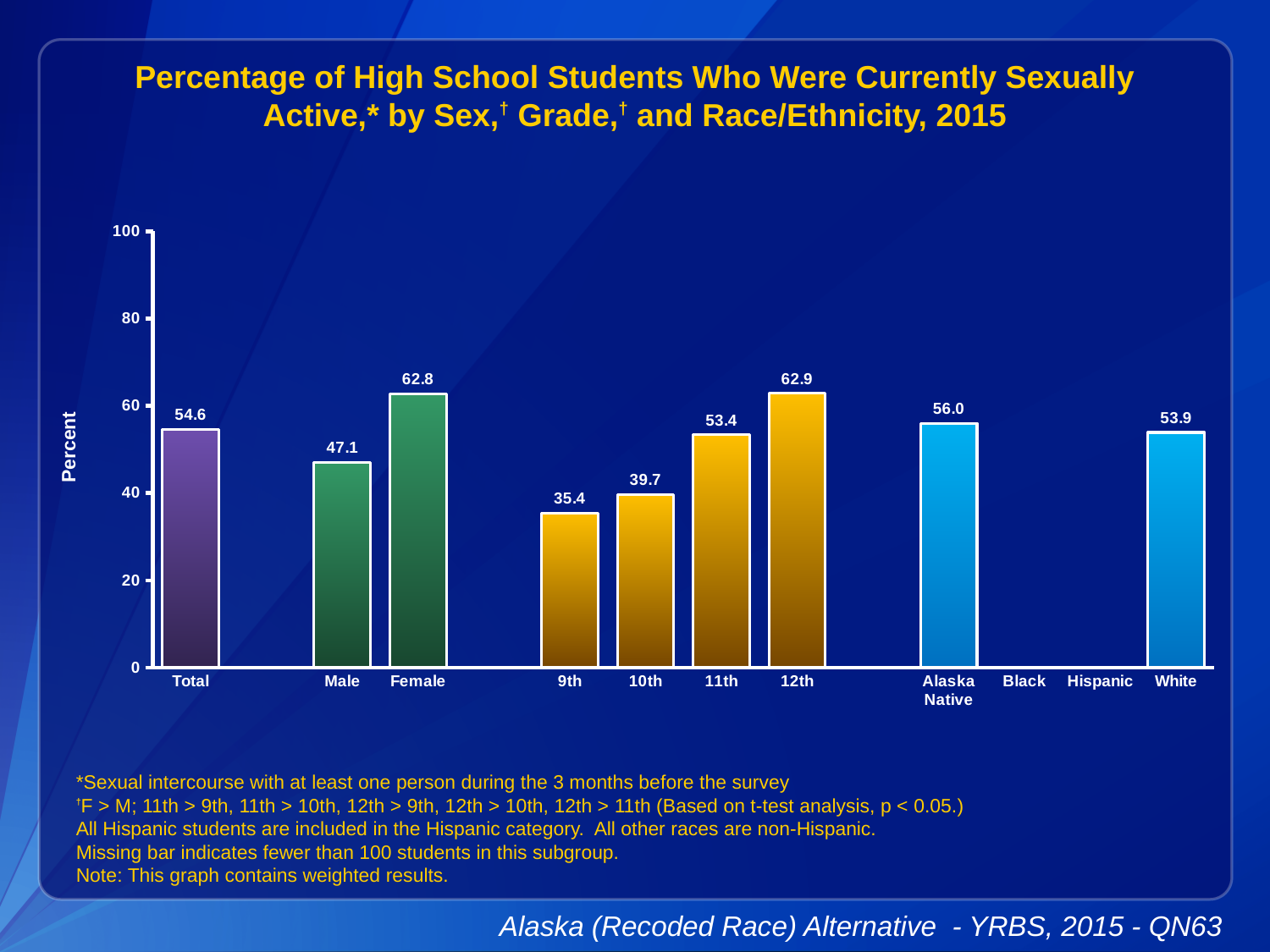
Which race/ethnicity categories have no bar shown? Black and Hispanic What kind of chart is shown? bar chart Which grade has the highest value? 12th Do the values rise or fall from 9th grade to 12th grade? rise Which category has the lowest value on the chart? 9th What is the value for Alaska Native? 56.0 What is the difference between the Female and Male values? 15.7 Which is larger, the value for 10th grade or the value for 11th grade? 11th What is the value for Female? 62.8 How many bars are plotted on the chart? 9 What is the value for Total? 54.6 What is the value for 9th grade? 35.4